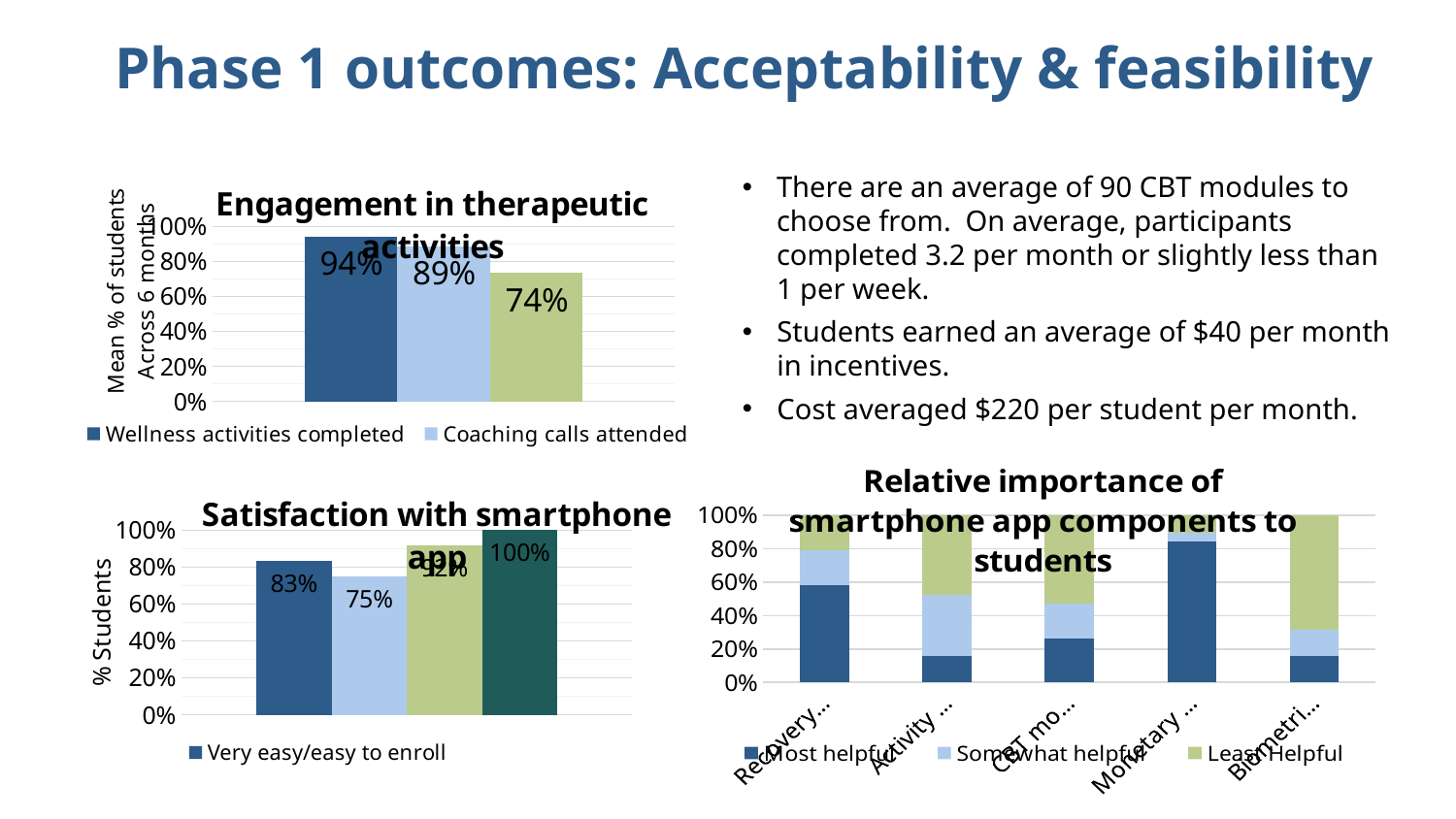
How many bars are plotted in the 'Engagement in therapeutic activities' chart? 3 In the 'Engagement in therapeutic activities' chart, what is the value for Coaching calls attended? 89% How many bars are plotted in the 'Satisfaction with smartphone app' chart? 4 In the 'Engagement in therapeutic activities' chart, what is the difference between Wellness activities completed and Coaching calls attended? 5 percentage points In the 'Satisfaction with smartphone app' chart, what is the value of the highest bar? 100% In the 'Satisfaction with smartphone app' chart, what is the value for Very easy/easy to enroll? 83% What kind of chart is the 'Relative importance of smartphone app components to students' chart? Stacked bar chart In the 'Satisfaction with smartphone app' chart, what is the value of the lowest bar? 75% In the 'Engagement in therapeutic activities' chart, what is the value for Wellness activities completed? 94% In the 'Relative importance of smartphone app components to students' chart, is the Most helpful segment for the 'Monetary ...' category greater or less than 80%? greater How many series does the legend list in the 'Relative importance of smartphone app components to students' chart? 3 In the 'Engagement in therapeutic activities' chart, what is the value of the lowest bar? 74%